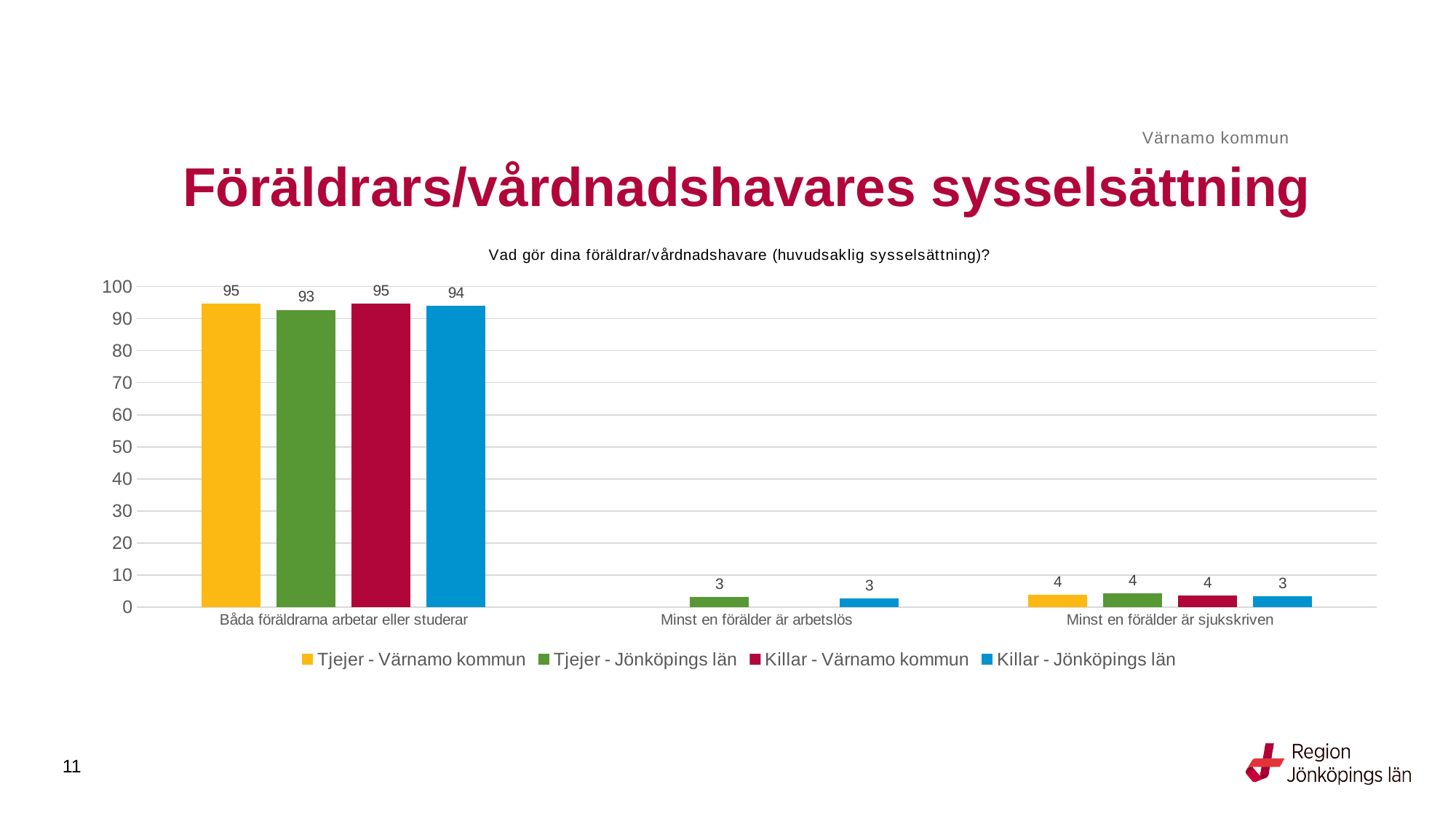
What question is shown as the chart's subtitle? Vad gör dina föräldrar/vårdnadshavare (huvudsaklig sysselsättning)? What is the value for Tjejer - Jönköpings län in the category 'Båda föräldrarna arbetar eller studerar'? 93 Which is larger for Killar - Jönköpings län: the value for 'Båda föräldrarna arbetar eller studerar' or for 'Minst en förälder är sjukskriven'? Båda föräldrarna arbetar eller studerar What is the value for Tjejer - Värnamo kommun in the category 'Båda föräldrarna arbetar eller studerar'? 95 Is the value for Killar - Jönköpings län in 'Båda föräldrarna arbetar eller studerar' greater or less than 50? greater Which series has the lowest value in the category 'Båda föräldrarna arbetar eller studerar'? Tjejer - Jönköpings län How many series does the legend list? 4 What is the value for Tjejer - Jönköpings län in the category 'Minst en förälder är arbetslös'? 3 What kind of chart is shown on the slide? Bar chart What is the difference between Killar - Värnamo kommun and Tjejer - Jönköpings län in the category 'Båda föräldrarna arbetar eller studerar'? 2 How many categories are shown on the x axis? 3 What is the value for Killar - Jönköpings län in the category 'Minst en förälder är sjukskriven'? 3